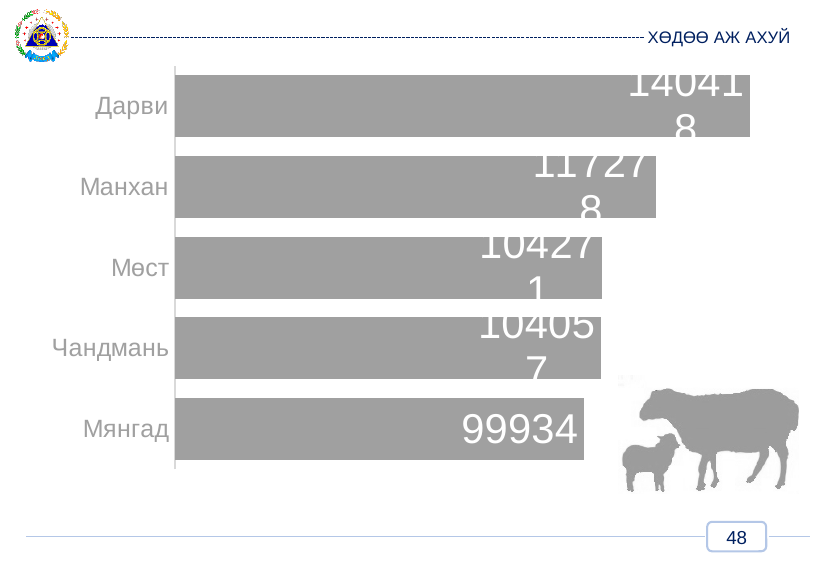
Which is larger, the value for Дарви or the value for Манхан? Дарви What is the value for Дарви? 140418 What is the difference between the values for Дарви and Мянгад? 40484 What is the value for Манхан? 117278 Which category has the highest value? Дарви What kind of chart is shown on the slide? Bar chart How many categories are shown in the chart? 5 What is the value for Чандмань? 104057 Which category has the lowest value? Мянгад What is the difference between the values for Манхан and Мөст? 13007 What is the value for Мөст? 104271 What is the value for Мянгад? 99934